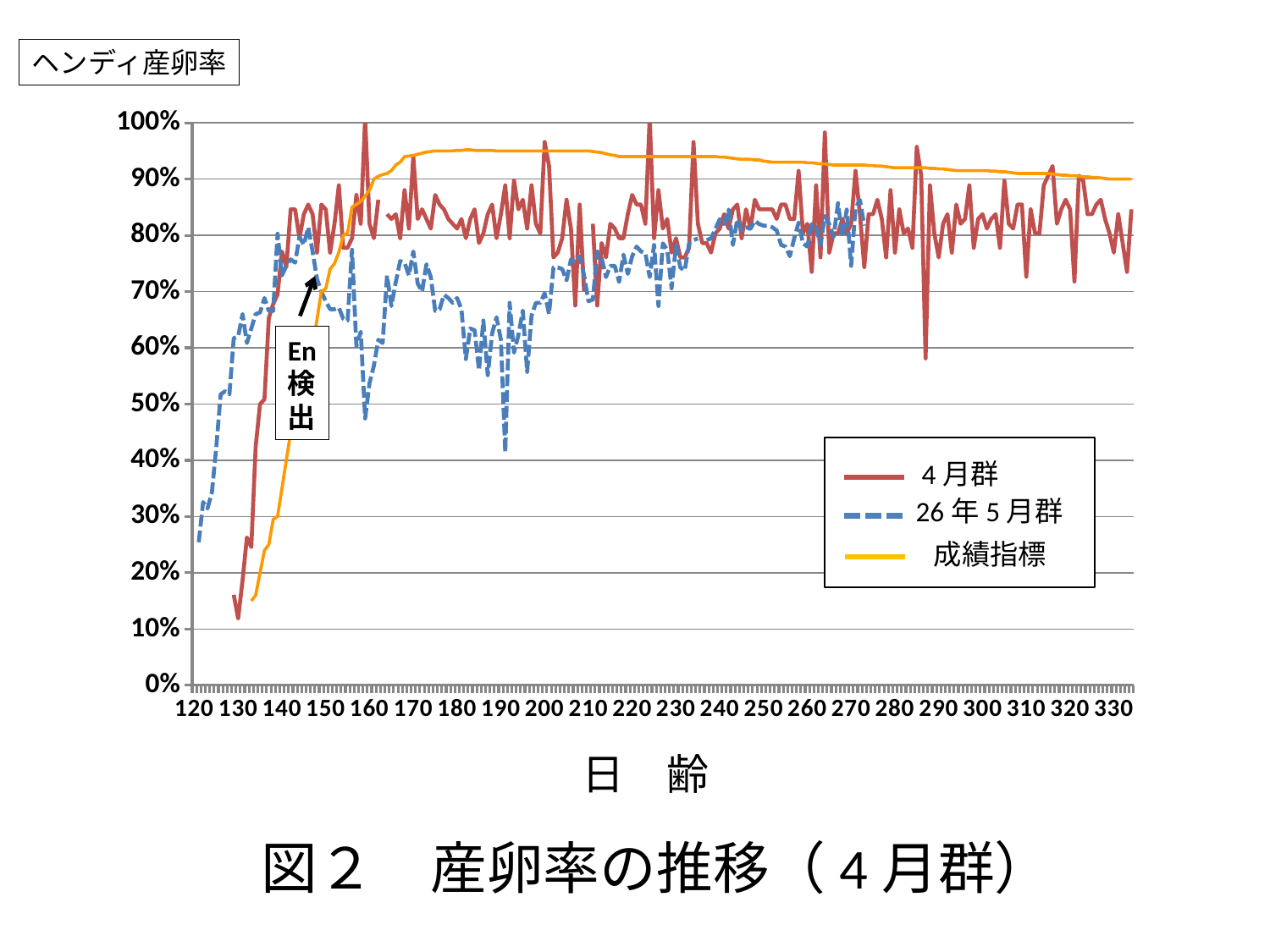
At 日齢 190, which series has the larger value, 4月群 or 26年5月群? 4月群 What kind of chart is shown on the slide? line chart Does the 成績指標 line rise or fall between 日齢 250 and 日齢 330? fall What is the label of the x axis? 日齢 Is the value of 4月群 at 日齢 130 greater or less than 20%? less What are the three series listed in the legend? 4月群, 26年5月群, 成績指標 Is the value of 成績指標 at 日齢 200 greater or less than 90%? greater Does the 成績指標 line rise or fall between 日齢 130 and 日齢 170? rise Is the lowest value of 26年5月群 near 日齢 190 greater or less than 50%? less At 日齢 130, which series has the larger value, 4月群 or 26年5月群? 26年5月群 How many series does the legend list? 3